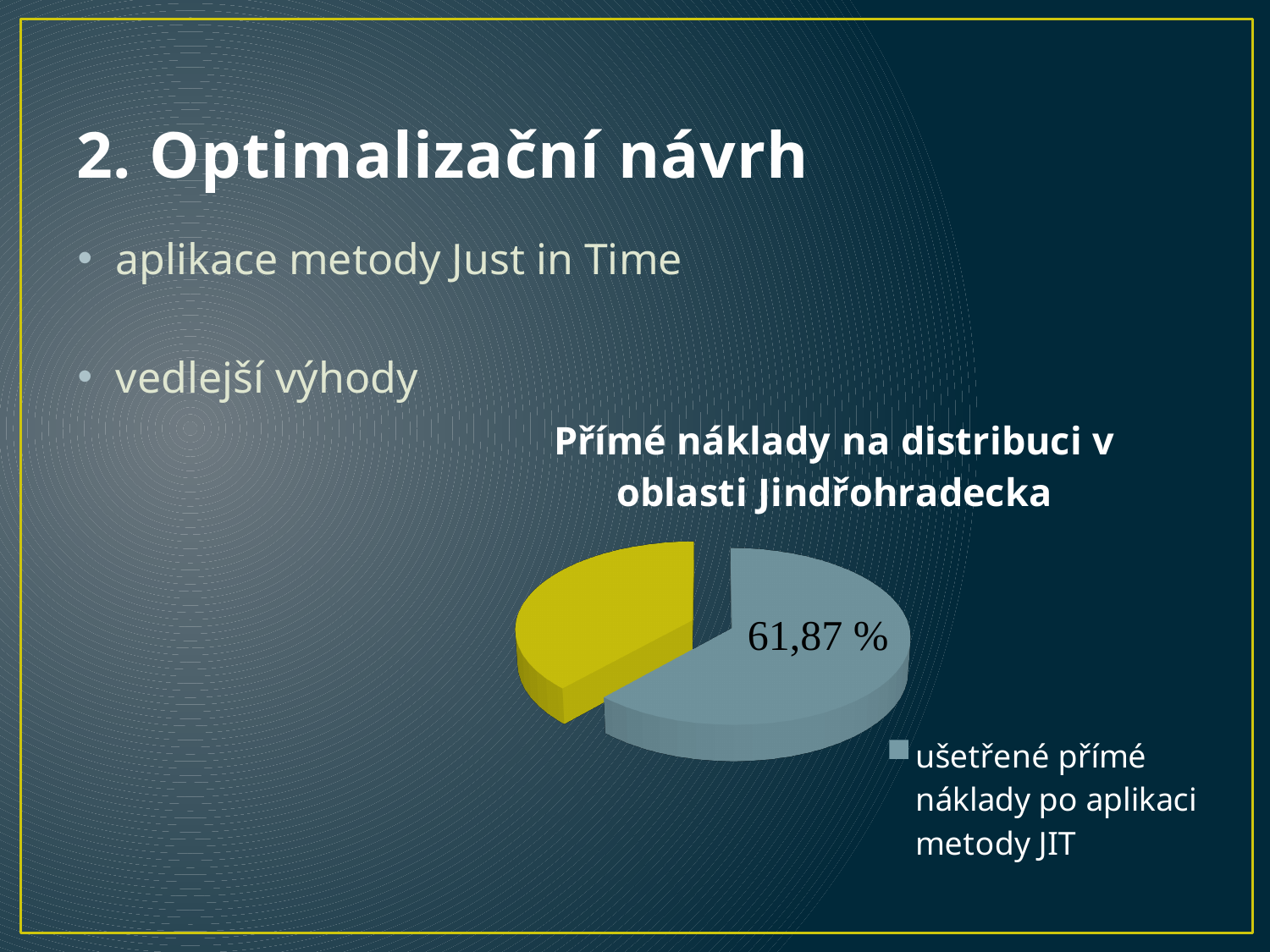
How many slices does the pie chart have? 2 What colour is the slice for "ušetřené přímé náklady po aplikaci metody JIT"? grey-blue What kind of chart is shown on the slide? pie chart What share of the pie does the slice "ušetřené přímé náklady po aplikaci metody JIT" take? 61,87 % What percentage is shown for the slice "ušetřené přímé náklady po aplikaci metody JIT"? 61,87 % Which slice of the pie is the largest? ušetřené přímé náklady po aplikaci metody JIT Which slice is larger, the yellow slice or the slice labelled 61,87 %? the slice labelled 61,87 % What is the title of the chart? Přímé náklady na distribuci v oblasti Jindřohradecka How many entries does the chart legend list? 1